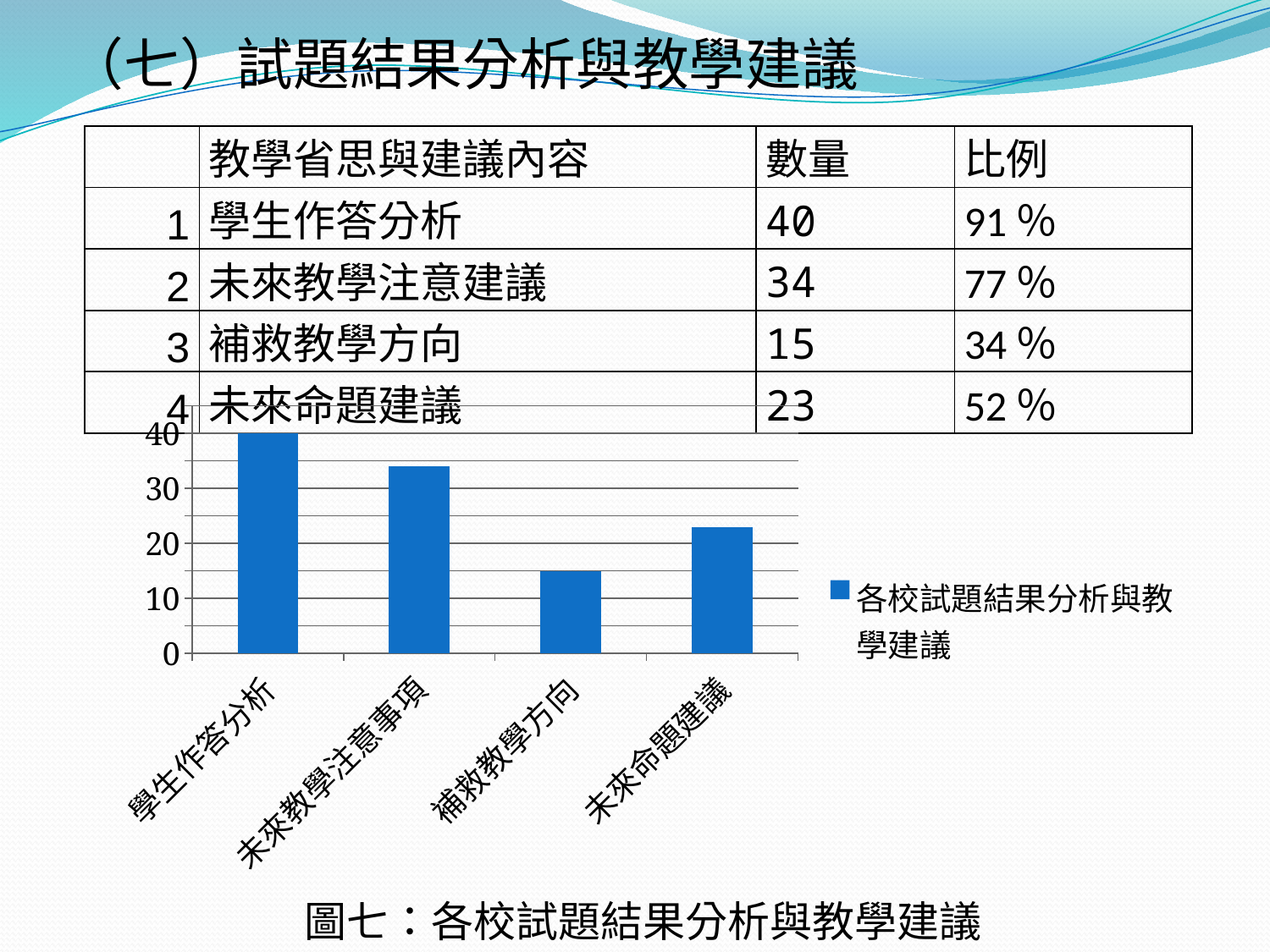
Is the value for 補救教學方向 in the chart greater or less than 20? less Is the value for 未來教學注意事項 in the chart greater or less than 30? greater What value does the bar for 學生作答分析 reach on the y axis? 40 Which category has the highest bar in the chart? 學生作答分析 In the chart, which is larger: the bar for 補救教學方向 or the bar for 未來命題建議? 未來命題建議 What kind of chart is shown on the slide? bar chart In the chart, which is larger: the bar for 未來教學注意事項 or the bar for 未來命題建議? 未來教學注意事項 How many series does the chart's legend list? 1 Which category has the lowest bar in the chart? 補救教學方向 What is the legend entry shown next to the chart? 各校試題結果分析與教學建議 How many categories are plotted on the x axis of the bar chart? 4 Is the value for 未來命題建議 in the chart greater or less than 20? greater